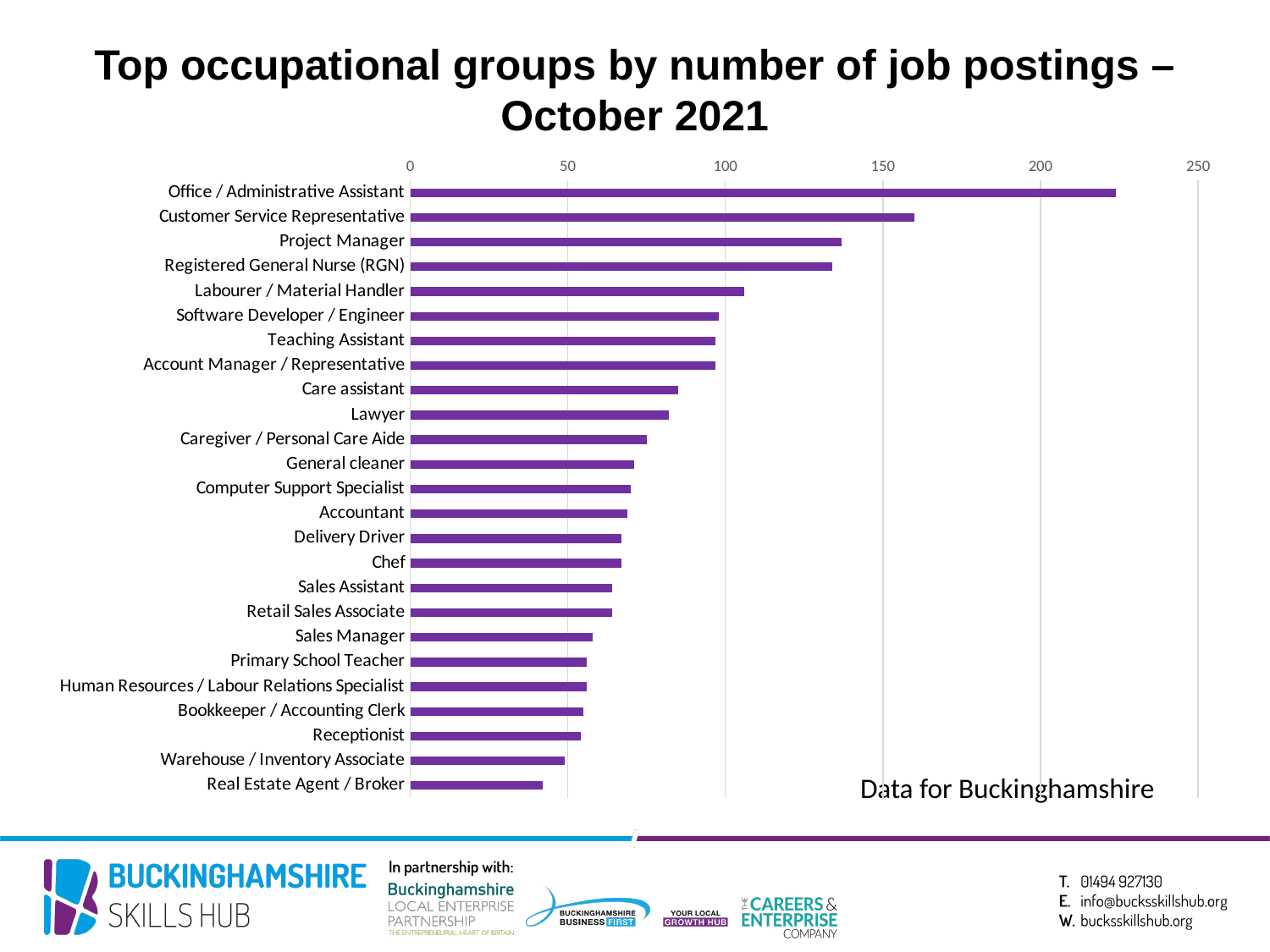
Which has more job postings, Office / Administrative Assistant or Customer Service Representative? Office / Administrative Assistant Is the value for Office / Administrative Assistant greater or less than 200? greater Which has more job postings, Project Manager or Lawyer? Project Manager What is the title of the chart? Top occupational groups by number of job postings – October 2021 Is the value for Real Estate Agent / Broker greater or less than 50? less How many occupational groups are shown in the chart? 25 What kind of chart is shown on the slide? Bar chart Is the value for Customer Service Representative greater or less than 150? greater Which occupational group has the lowest number of job postings? Real Estate Agent / Broker Which occupational group has the highest number of job postings? Office / Administrative Assistant